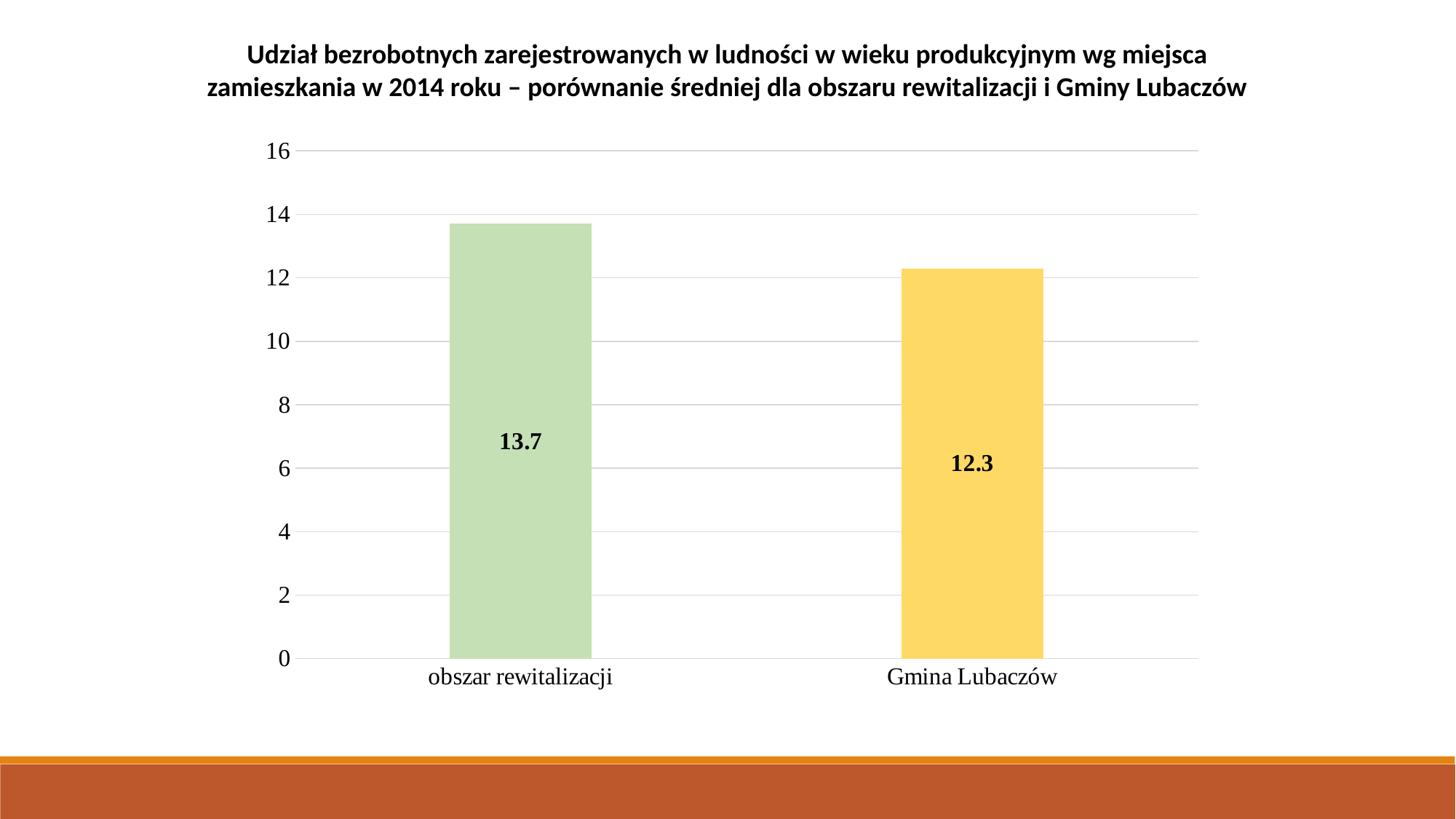
Which category has the lowest value? Gmina Lubaczów Is the value for Gmina Lubaczów greater or less than 14? less How many categories are shown on the chart? 2 What colour is the bar for Gmina Lubaczów? yellow Is the value for obszar rewitalizacji greater or less than 12? greater What kind of chart is shown on the slide? bar chart What is the value for obszar rewitalizacji? 13.7 What is the value for Gmina Lubaczów? 12.3 What is the highest value shown on the vertical axis? 16 Which category has the highest value? obszar rewitalizacji Which is larger, the value for obszar rewitalizacji or the value for Gmina Lubaczów? obszar rewitalizacji What is the difference between the values for obszar rewitalizacji and Gmina Lubaczów? 1.4